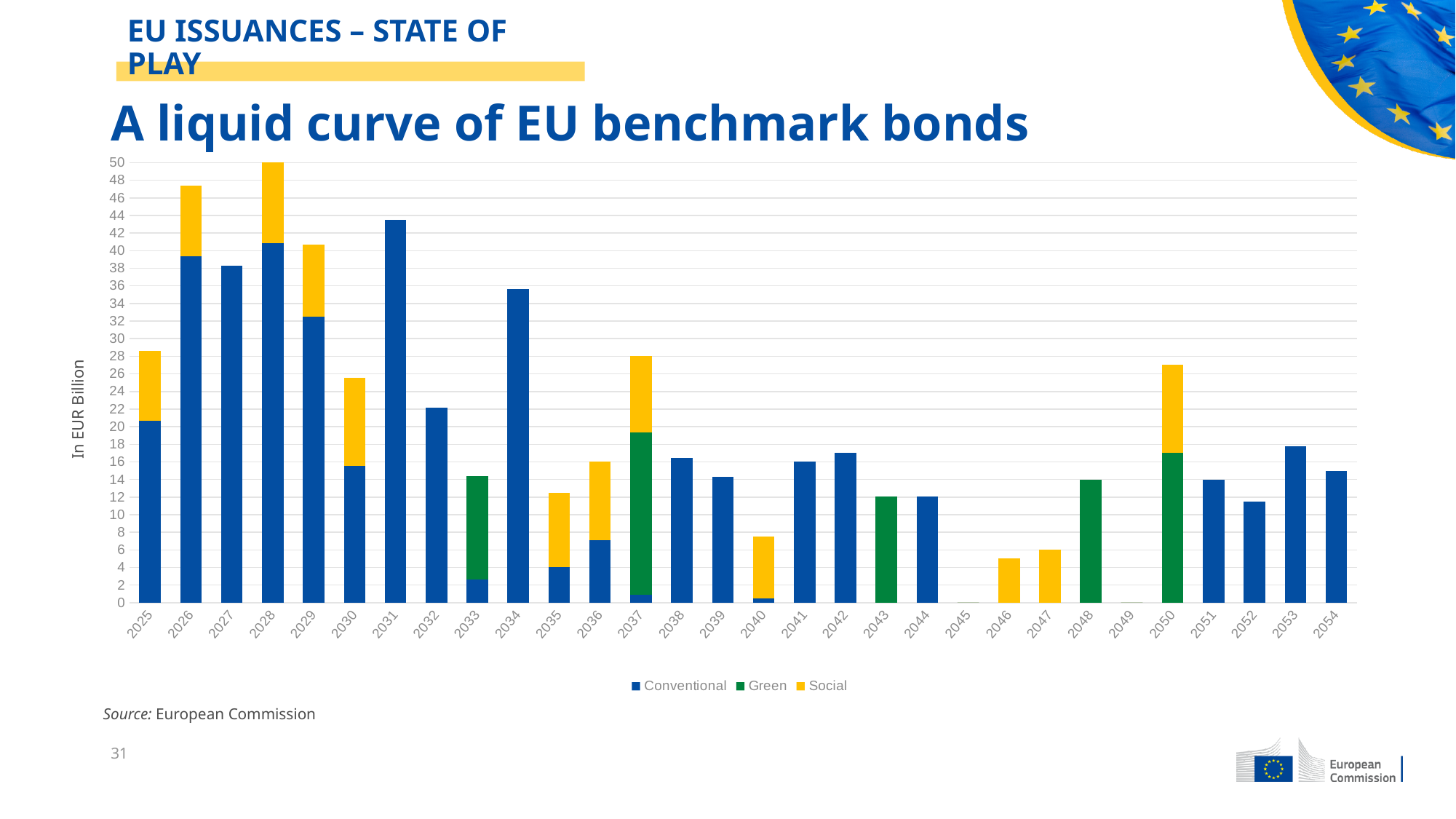
Which year has the larger bar, 2052 or 2053? 2053 What kind of chart is shown on the slide? bar chart What is the label on the vertical axis? In EUR Billion Is the value for 2031 greater or less than 40? greater How many series does the legend list? 3 How many years are shown along the x axis? 30 Is the total value for 2050 greater or less than 20? greater Which year has the tallest stacked bar? 2028 Do the bar values rise or fall from 2038 to 2040? fall Is the total value for 2025 greater or less than 30? less Which year has the larger bar, 2032 or 2034? 2034 What are the three series named in the legend? Conventional, Green, Social